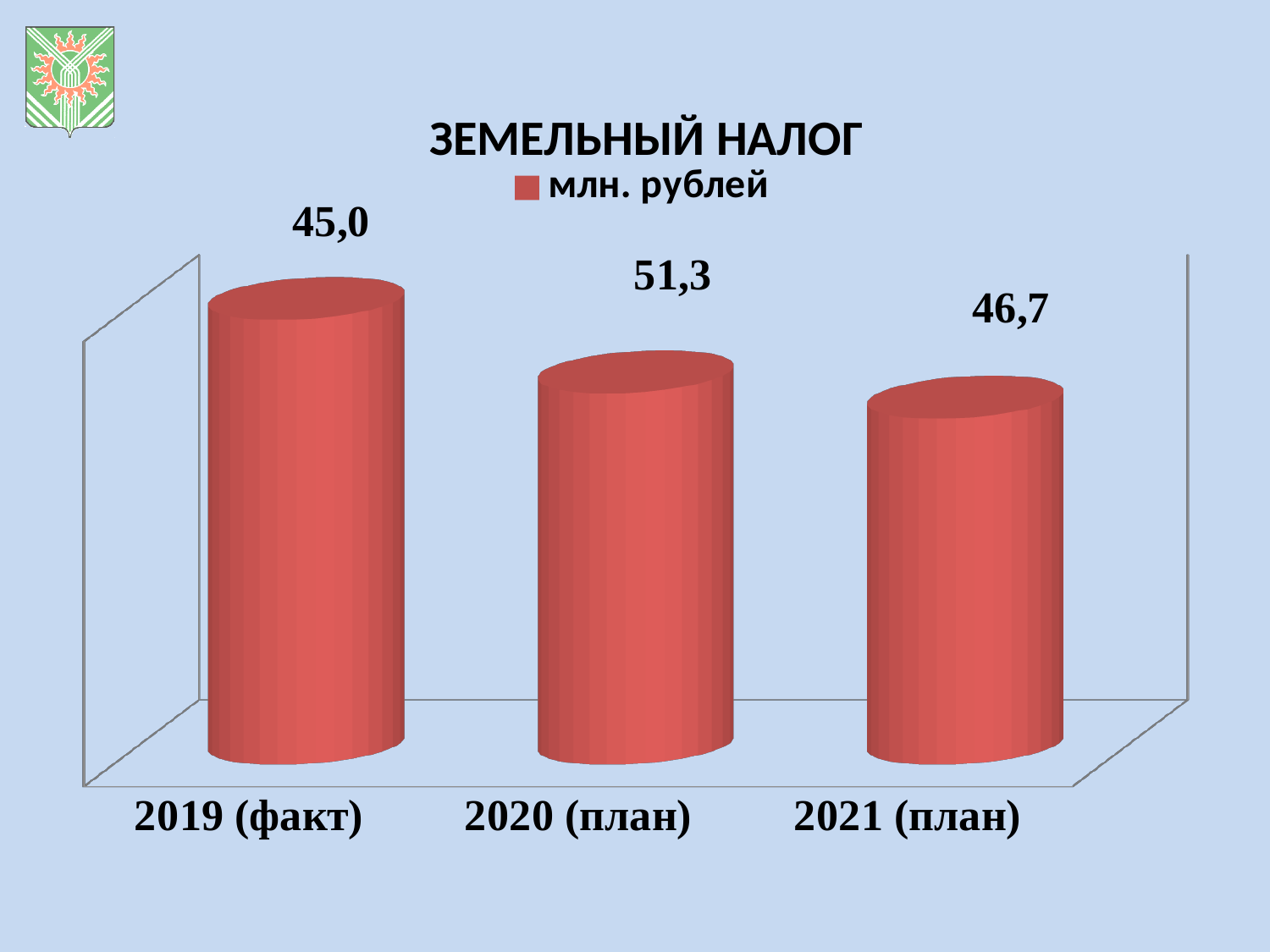
How many categories are shown on the x axis? 3 What is the value for 2020 (план)? 51,3 What is the value for 2019 (факт)? 45,0 What kind of chart is shown on the slide? bar chart What is the difference between the values for 2021 (план) and 2019 (факт)? 1,7 What is the difference between the values for 2020 (план) and 2021 (план)? 4,6 What is the value for 2021 (план)? 46,7 What is the difference between the values for 2020 (план) and 2019 (факт)? 6,3 What is the legend entry of the chart? млн. рублей What is the title of the chart? ЗЕМЕЛЬНЫЙ НАЛОГ How many series does the legend list? 1